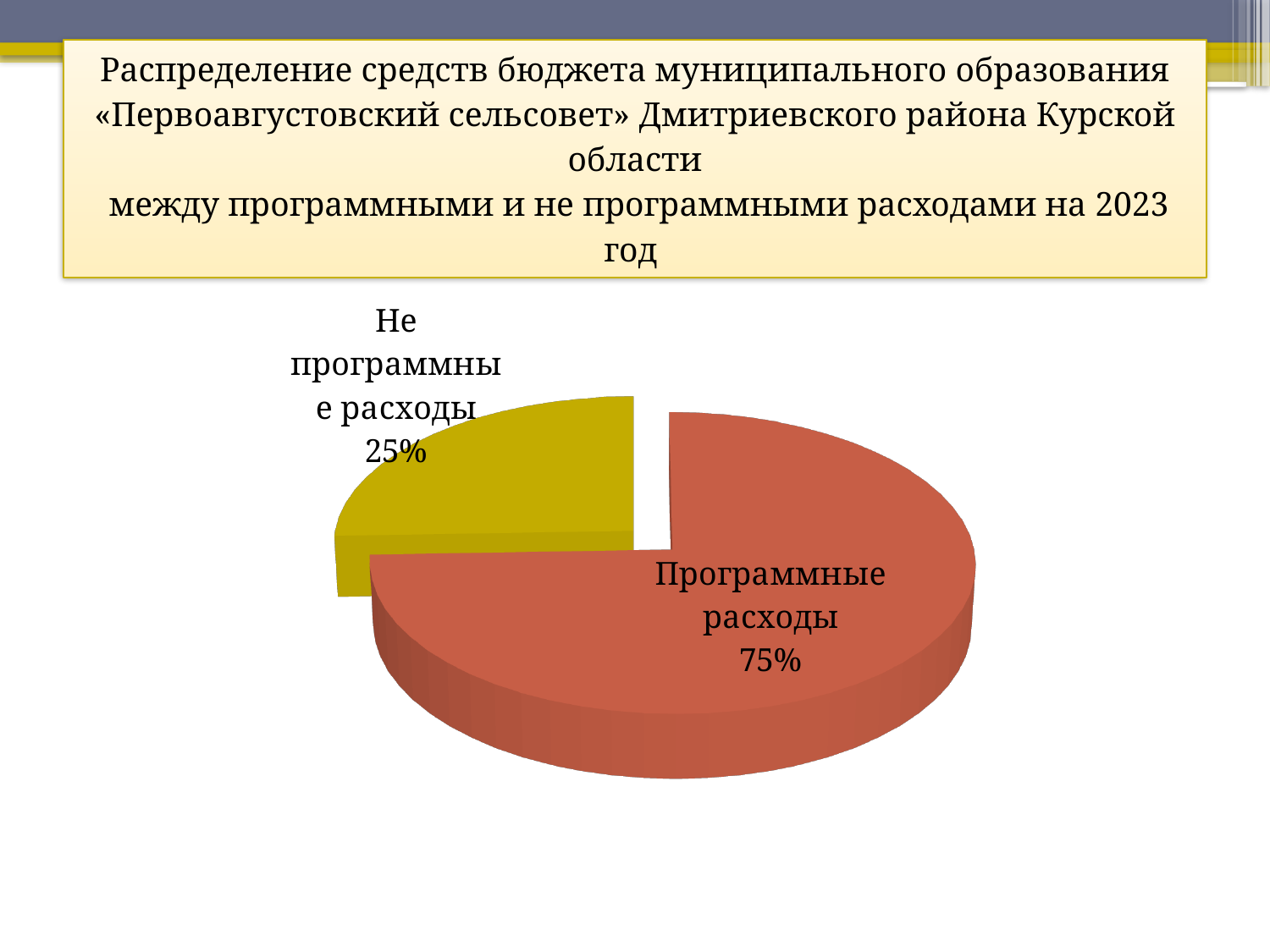
What colour is the "Программные расходы" slice? Red How many slices does the pie chart have? 2 What share of the pie is labelled "Не программные расходы"? 25% What share of the pie is labelled "Программные расходы"? 75% Which is larger: the "Программные расходы" slice or the "Не программные расходы" slice? Программные расходы Is the share for "Не программные расходы" greater or less than 50%? less Is the share for "Программные расходы" greater or less than 50%? greater Which slice of the pie is the largest? Программные расходы What is the difference in percentage points between the "Программные расходы" and "Не программные расходы" slices? 50 What colour is the "Не программные расходы" slice? Yellow What kind of chart is shown on the slide? Pie chart Which slice of the pie is the smallest? Не программные расходы